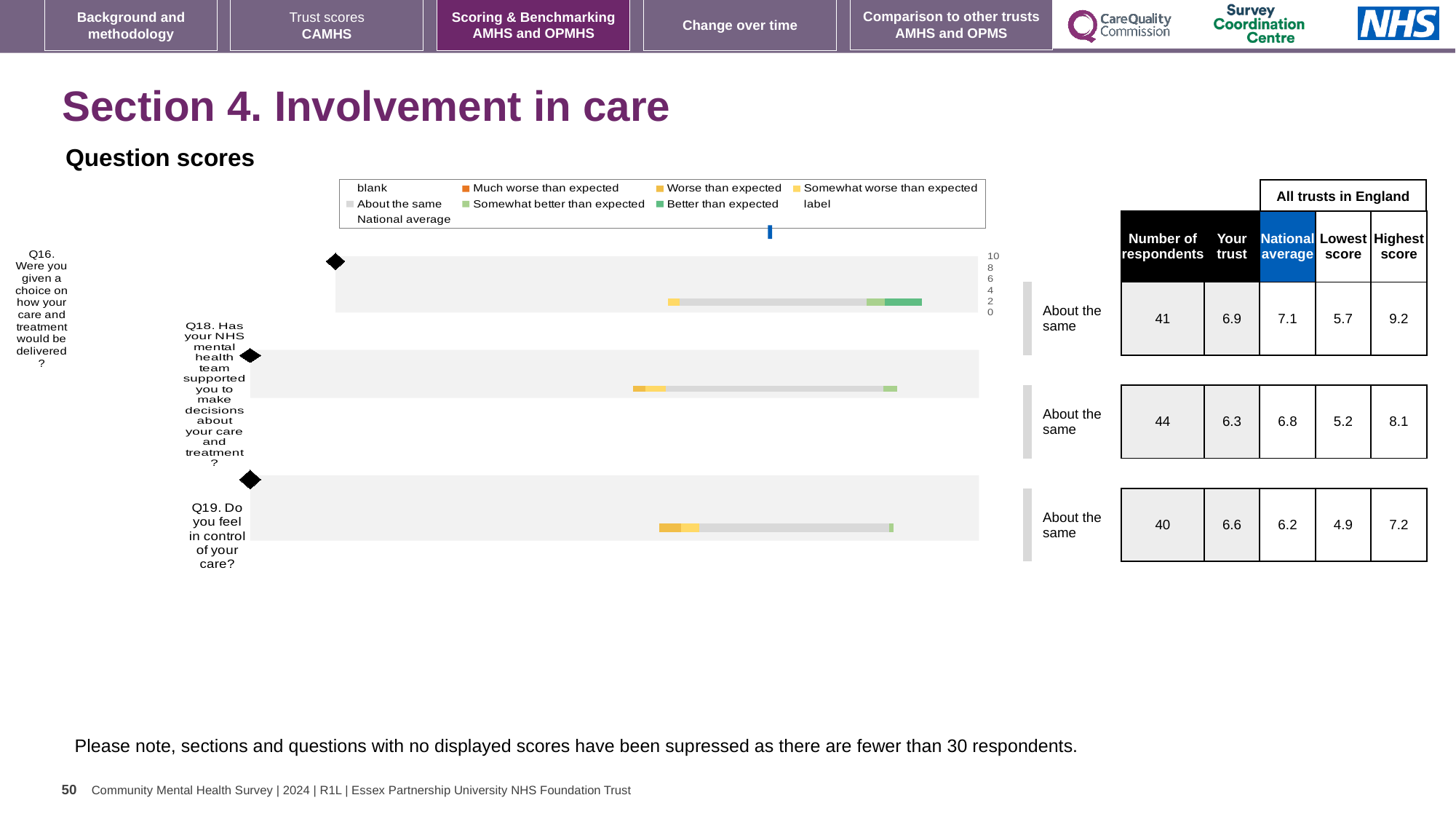
How many respondents answered Q19 (Do you feel in control of your care?)? 40 What benchmark category label is shown next to the bar for Q16? About the same Which question has the lowest 'Lowest score' among all trusts in England? Q19 What kind of chart is used to show the question scores on this slide? Bar chart What is the 'Your trust' score for Q16 (Were you given a choice on how your care and treatment would be delivered?)? 6.9 What is the highest score across all trusts in England for Q18? 8.1 Which question has the highest 'Your trust' score? Q16 What colour does the legend use for 'Much worse than expected'? Orange For Q19, which is larger: the 'Your trust' score or the national average? Your trust What is the difference between the highest score and the lowest score for Q16? 3.5 What is the national average score for Q18 (Has your NHS mental health team supported you to make decisions about your care and treatment?)? 6.8 How many questions are plotted in the question scores chart? 3